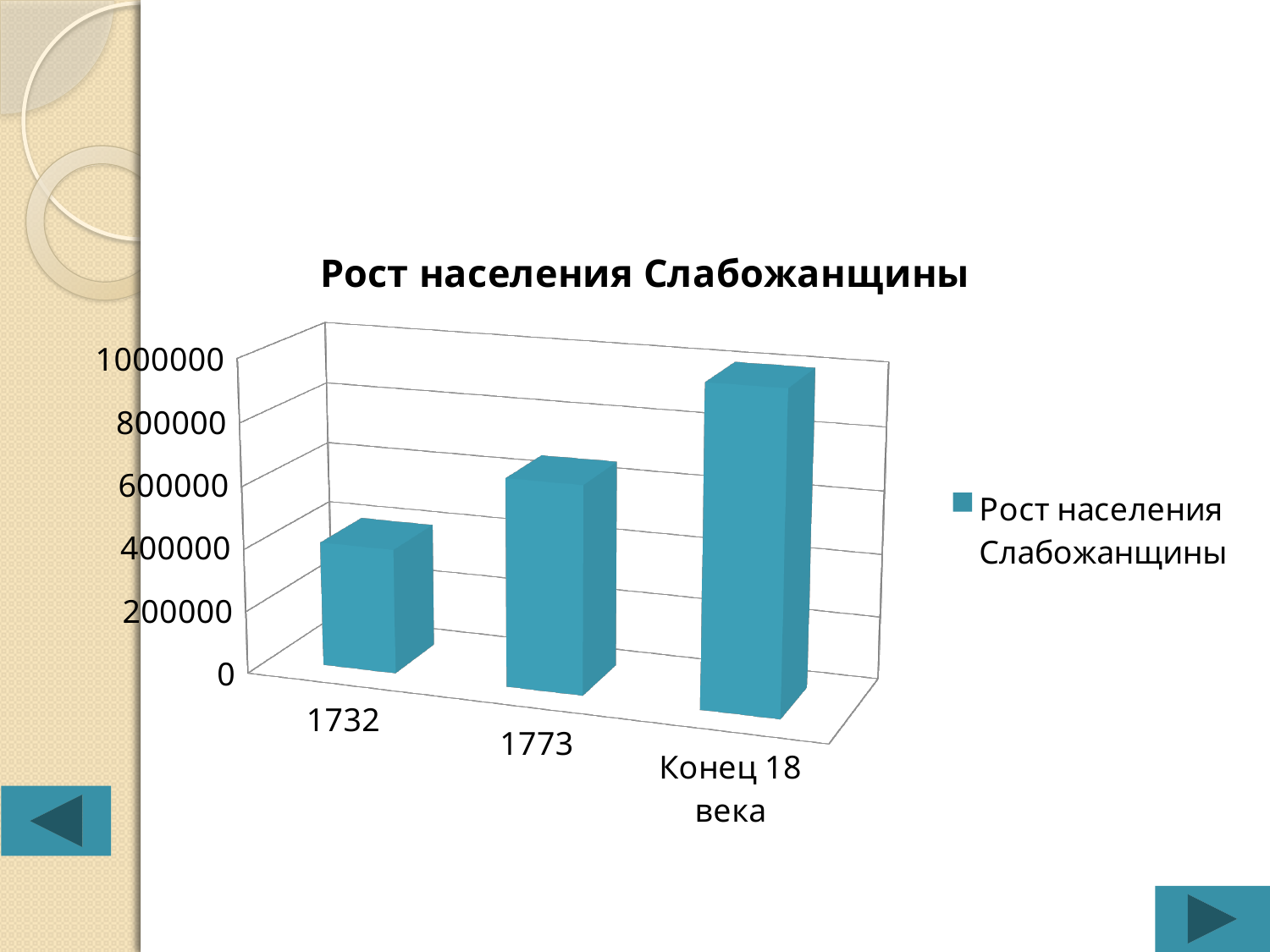
What is the title of the chart? Рост населения Слабожанщины How many series does the legend list? 1 What kind of chart is shown on the slide? bar chart Is the value for 1732 greater or less than 600000? less What is the name of the series shown in the legend? Рост населения Слабожанщины Do the values rise or fall from 1732 to Конец 18 века? rise Is the value for Конец 18 века greater or less than 600000? greater Which category has the highest bar? Конец 18 века Is the value for 1773 greater or less than 800000? less Which is larger, the value for 1773 or the value for 1732? 1773 Which category has the lowest bar? 1732 How many categories are shown on the x axis of the chart? 3